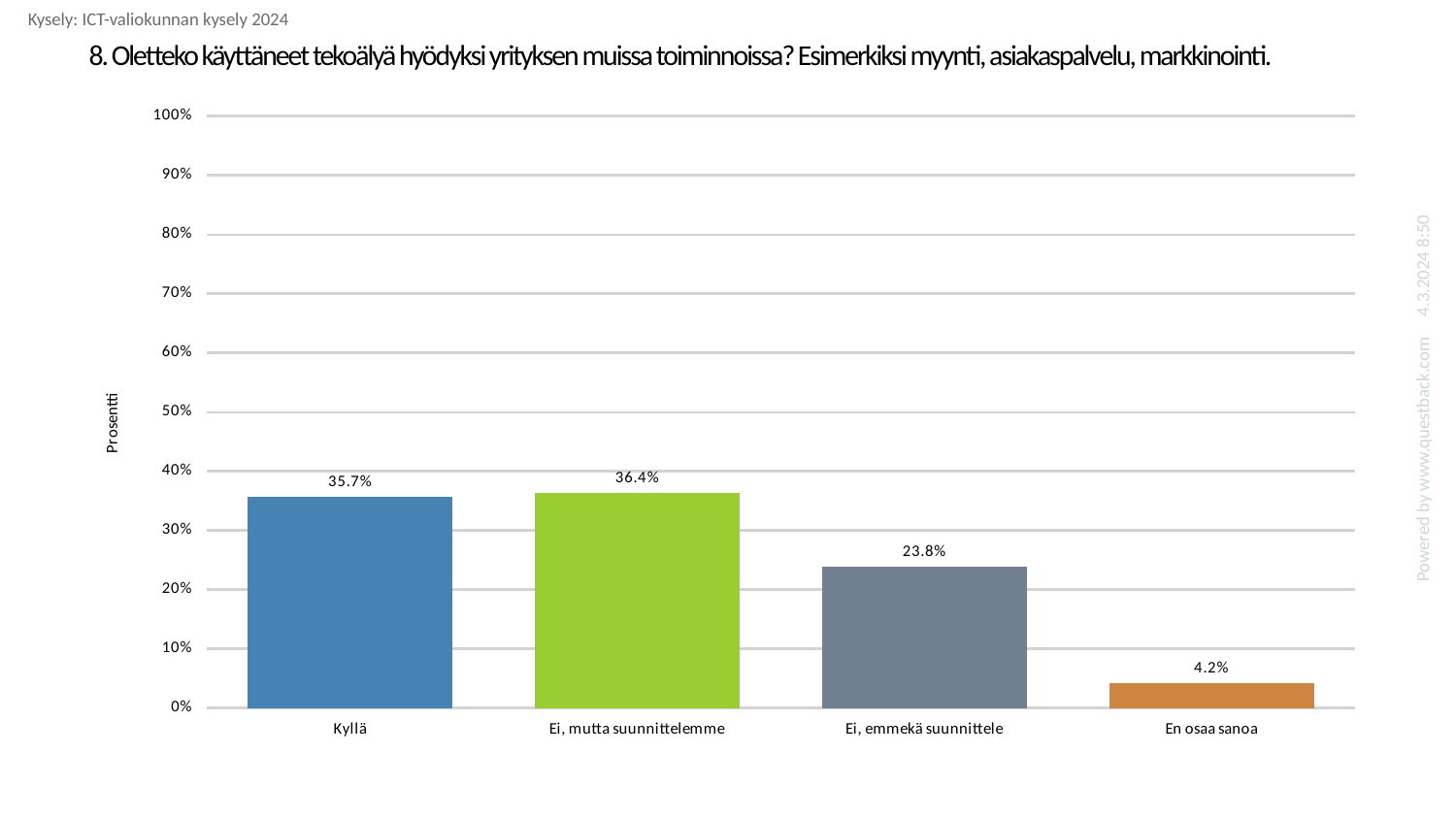
Which category has the lowest value? En osaa sanoa What is the value for "Ei, mutta suunnittelemme"? 36.4% Which category has the highest value? Ei, mutta suunnittelemme Which is larger, the value for "Ei, emmekä suunnittele" or the value for "En osaa sanoa"? Ei, emmekä suunnittele What is the value for "Kyllä"? 35.7% What is the difference between the values for "Kyllä" and "Ei, emmekä suunnittele"? 11.9% What is the value for "En osaa sanoa"? 4.2% How many categories are shown on the x axis? 4 What kind of chart is shown on the slide? bar chart Is the value for "Ei, emmekä suunnittele" greater or less than 30%? less What is the value for "Ei, emmekä suunnittele"? 23.8% What is the label of the y axis? Prosentti